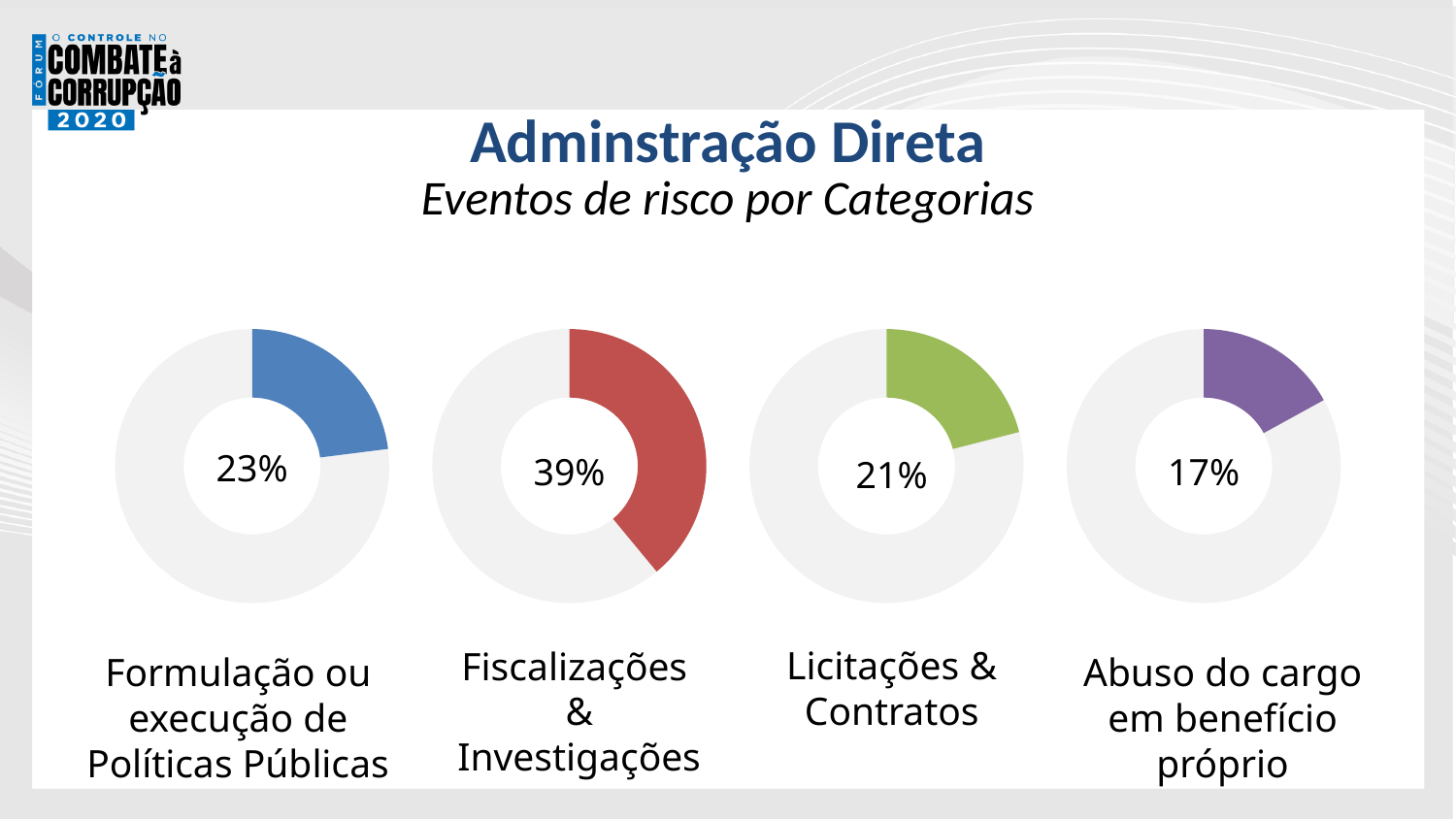
In the doughnut chart labelled 'Formulação ou execução de Políticas Públicas', what percentage is shown? 23% In the doughnut chart labelled 'Licitações & Contratos', what percentage is shown? 21% What type of chart is used for each of the four categories on the slide? Doughnut chart Across the four doughnut charts on the slide, which category has the highest percentage? Fiscalizações & Investigações In the doughnut chart labelled 'Fiscalizações & Investigações', what percentage is shown? 39% Comparing the 'Fiscalizações & Investigações' chart and the 'Formulação ou execução de Políticas Públicas' chart, what is the difference between their percentages? 16% Across the four doughnut charts on the slide, which category has the lowest percentage? Abuso do cargo em benefício próprio Which is larger: the percentage in the 'Formulação ou execução de Políticas Públicas' chart or the percentage in the 'Licitações & Contratos' chart? Formulação ou execução de Políticas Públicas What colour is the filled segment in the 'Fiscalizações & Investigações' doughnut chart? Red In the doughnut chart labelled 'Abuso do cargo em benefício próprio', what percentage is shown? 17% How many doughnut charts are shown on the slide? 4 Comparing the 'Licitações & Contratos' chart and the 'Abuso do cargo em benefício próprio' chart, what is the difference between their percentages? 4%